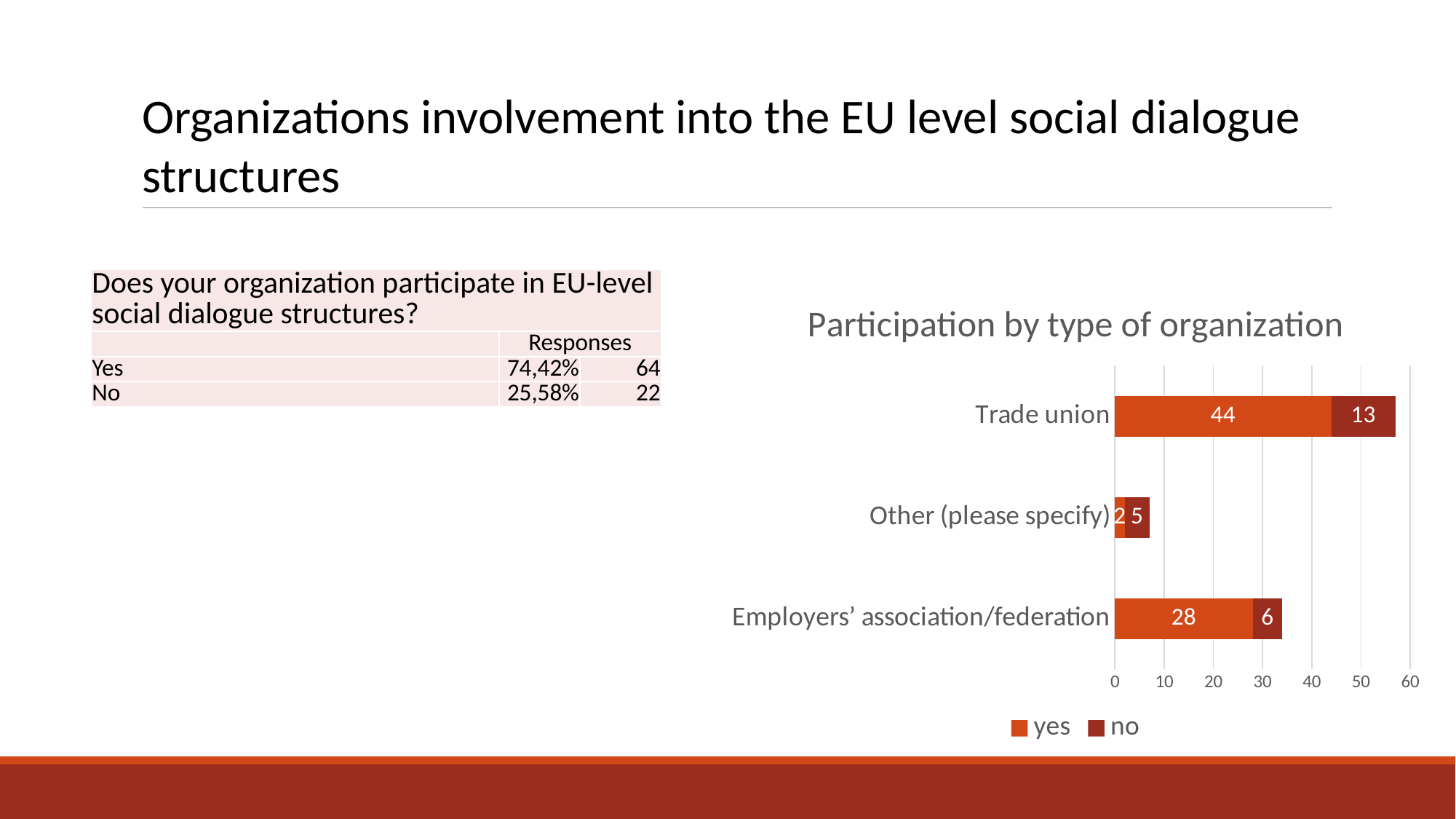
Which category has the highest 'yes' value? Trade union How many categories are shown on the chart? 3 What is the difference between the 'yes' values for Trade union and Employers' association/federation? 16 What kind of chart is shown on the slide? bar chart Which category has the lowest 'no' value? Other (please specify) What is the title of the chart? Participation by type of organization What is the total of the stacked bar for Trade union? 57 Is the 'no' value for Trade union larger than the 'no' value for Other (please specify)? yes How many series does the chart's legend list? 2 What is the 'yes' value for Trade union? 44 What is the 'yes' value for Other (please specify)? 2 What is the 'no' value for Employers' association/federation? 6